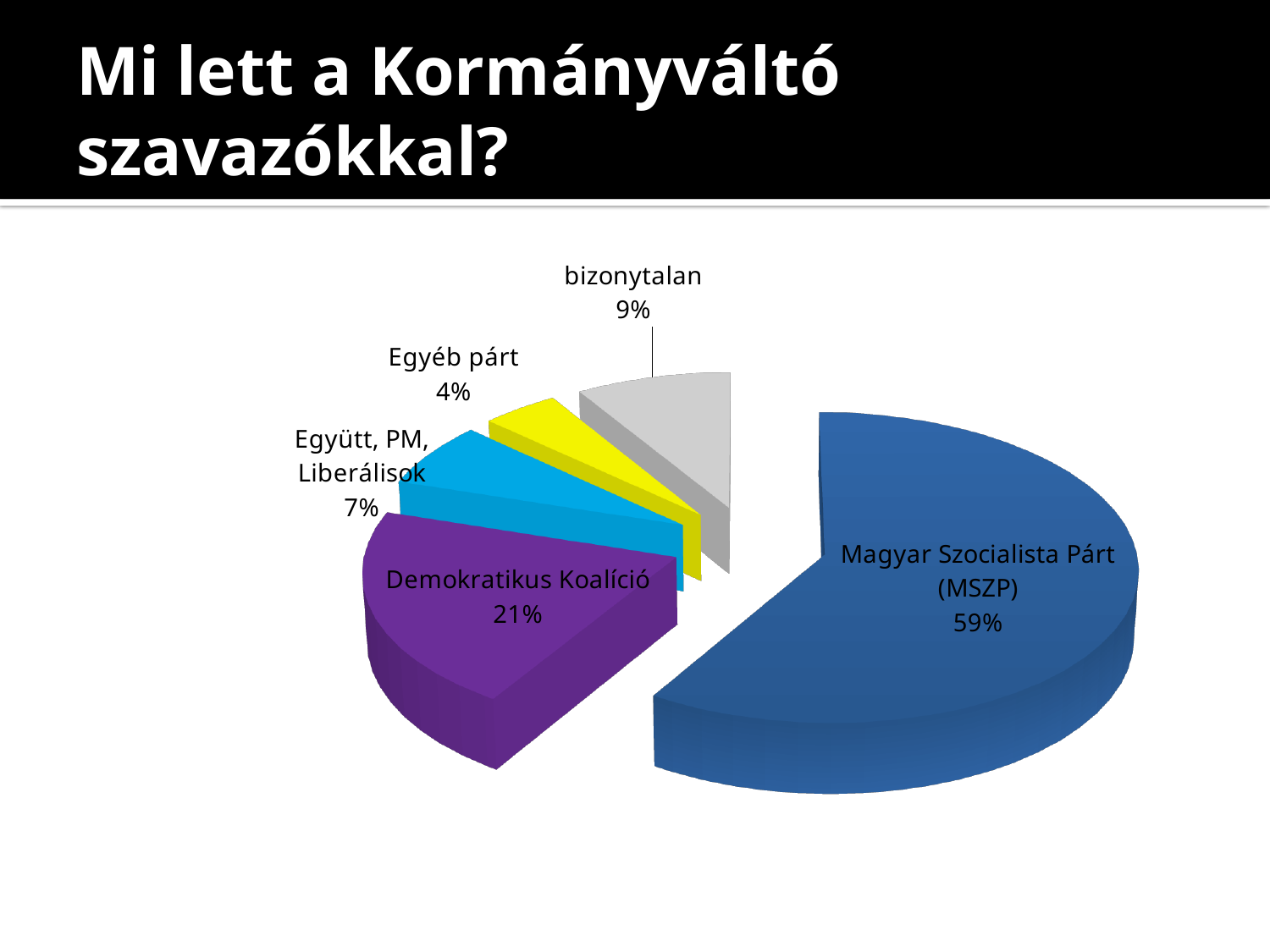
What share of the pie does Magyar Szocialista Párt (MSZP) have? 59% What is the difference between the shares of Magyar Szocialista Párt (MSZP) and Demokratikus Koalíció? 38% Which is larger, the share for bizonytalan or the share for Együtt, PM, Liberálisok? bizonytalan What is the value for Egyéb párt? 4% What is the value for bizonytalan? 9% What colour is the slice for Demokratikus Koalíció? purple What is the value for Együtt, PM, Liberálisok? 7% Which category has the smallest slice of the pie? Egyéb párt What share of the pie does Demokratikus Koalíció have? 21% What kind of chart is shown on the slide? pie chart How many slices does the pie chart have? 5 Which category has the largest slice of the pie? Magyar Szocialista Párt (MSZP)